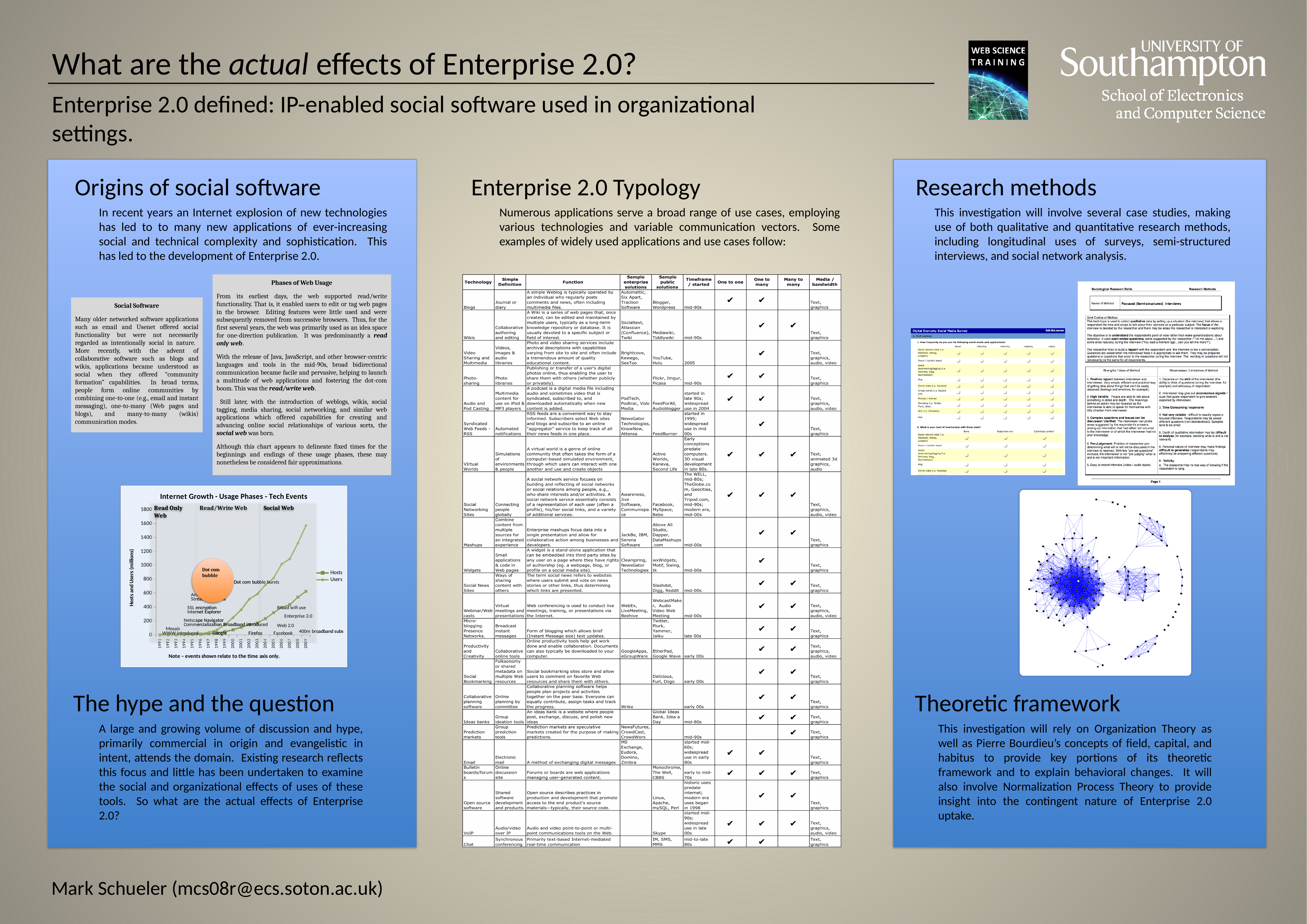
What are the two series named in the legend of the "Internet Growth - Usage Phases - Tech Events" chart? Hosts and Users What kind of chart is the "Internet Growth - Usage Phases - Tech Events" chart? line chart In the "Internet Growth - Usage Phases - Tech Events" chart, do the Users values rise or fall from 1991 to 2009? rise In the "Internet Growth - Usage Phases - Tech Events" chart, is the Hosts value for 2009 greater or less than 1000? less How many series does the legend of the "Internet Growth - Usage Phases - Tech Events" chart list? 2 In the "Internet Growth - Usage Phases - Tech Events" chart, which year has the highest Users value? 2009 What is the y-axis label of the "Internet Growth - Usage Phases - Tech Events" chart? Hosts and Users (millions) How many years are shown on the x-axis of the "Internet Growth - Usage Phases - Tech Events" chart? 19 In the "Internet Growth - Usage Phases - Tech Events" chart, which series has the larger value in 2009, Hosts or Users? Users In the "Internet Growth - Usage Phases - Tech Events" chart, is the Users value for 2009 greater or less than 1400? greater In the "Internet Growth - Usage Phases - Tech Events" chart, do the Hosts values rise or fall from 1991 to 2009? rise What is the highest tick value shown on the y-axis of the "Internet Growth - Usage Phases - Tech Events" chart? 1800